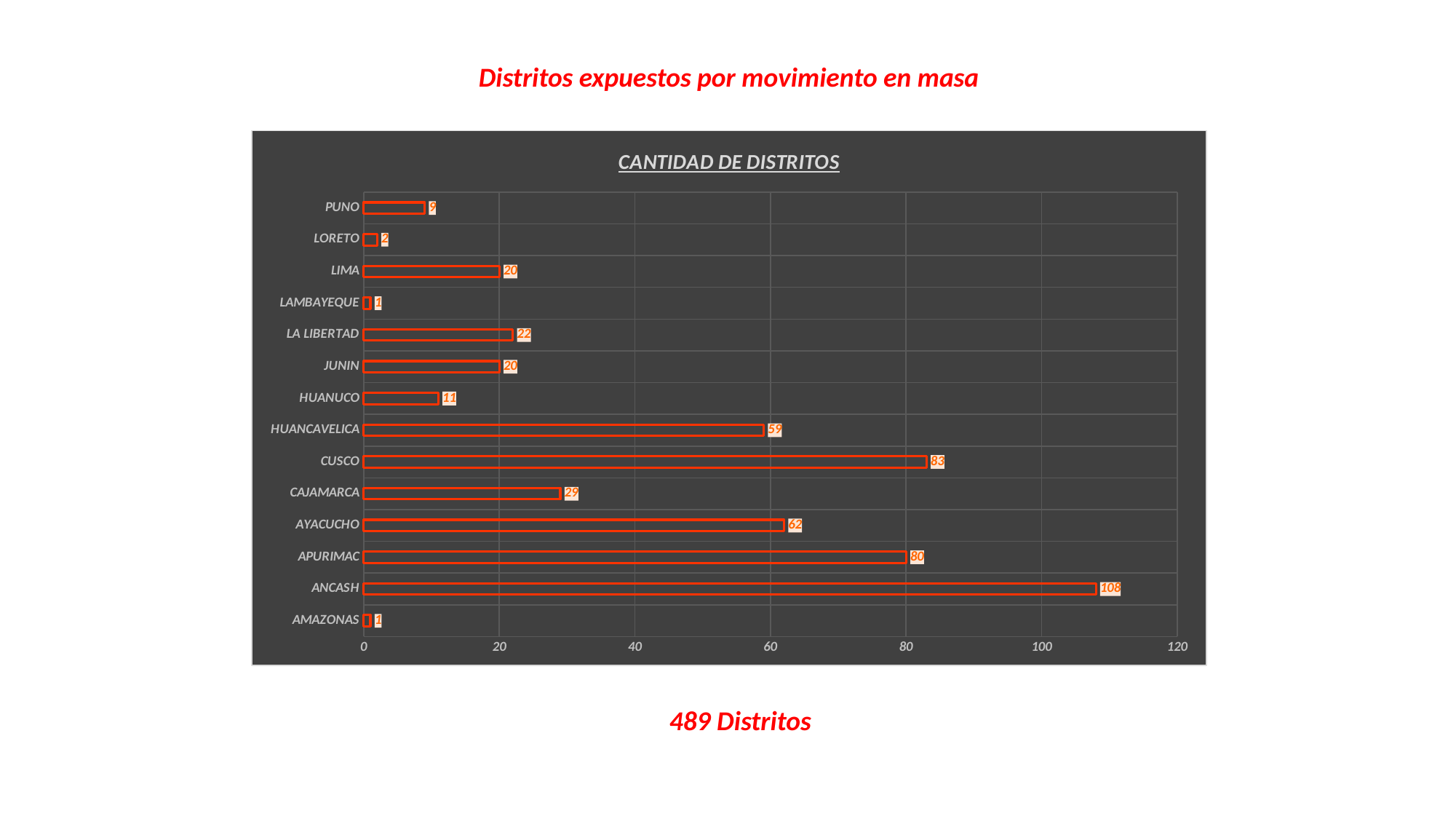
What is the value for LORETO? 2 Is the value for CUSCO greater or less than 80? greater Which is larger, the value for AYACUCHO or the value for HUANCAVELICA? AYACUCHO What is the difference between the values for CUSCO and APURIMAC? 3 What is the value for CAJAMARCA? 29 What is the title of the chart? CANTIDAD DE DISTRITOS What kind of chart is shown on the slide? bar chart What is the value for ANCASH? 108 Which category has the highest value? ANCASH What is the difference between the values for LA LIBERTAD and HUANUCO? 11 How many categories are shown in the chart? 14 What is the value for HUANCAVELICA? 59